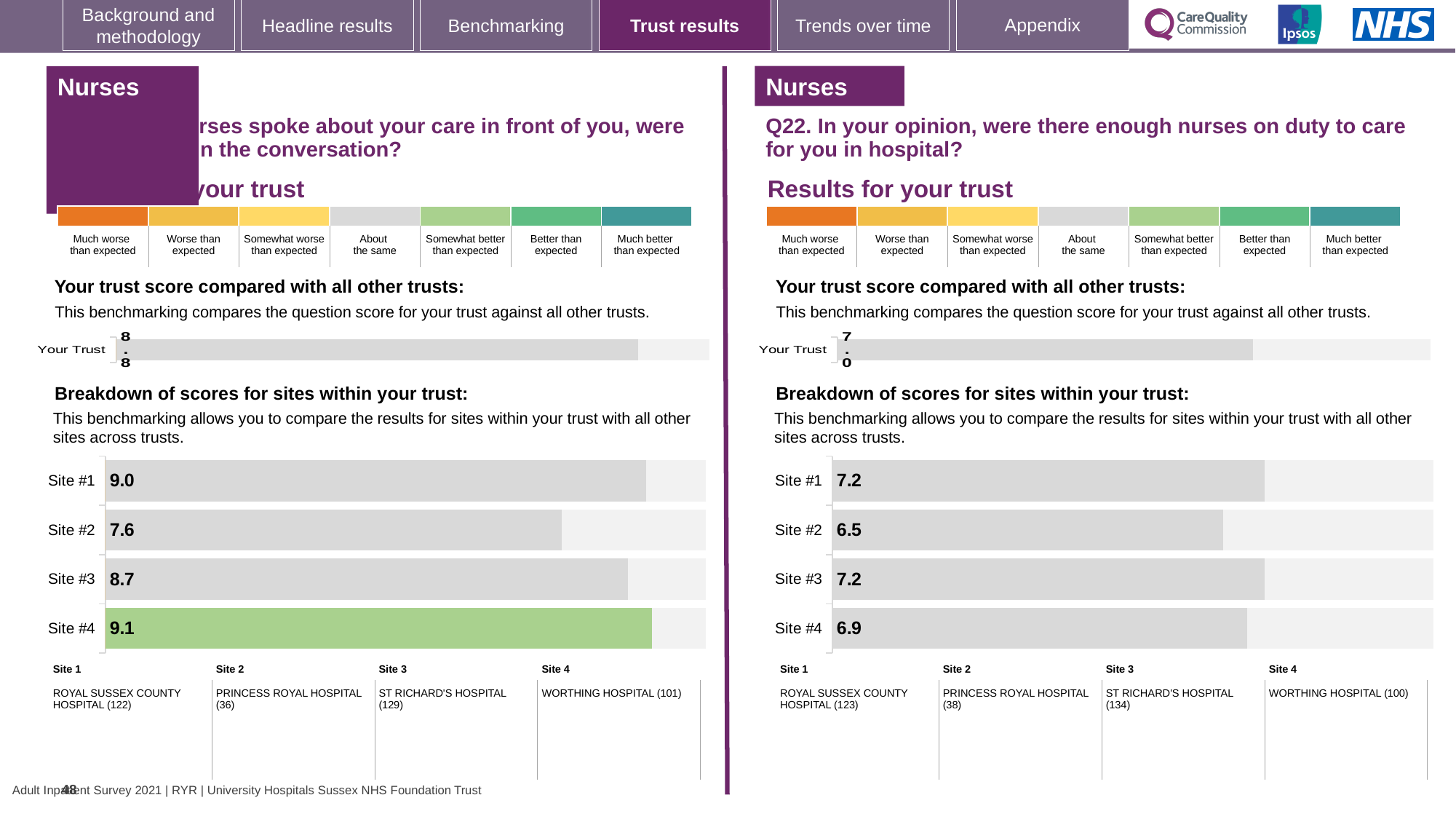
In the left-hand site breakdown chart, which site's bar is coloured green rather than grey? Site #4 In the right-hand site breakdown chart (Q22), what is the difference between the scores for Site #1 and Site #4? 0.3 What is the 'Your Trust' score shown in the right-hand panel (Q22)? 7.0 In the right-hand site breakdown chart (Q22), what is the score for Site #2? 6.5 In the left-hand site breakdown chart, what is the difference between the scores for Site #4 and Site #2? 1.5 How many sites are shown in the left-hand site breakdown chart? 4 In the left-hand site breakdown chart, which site has the lowest score? Site #2 In the left-hand site breakdown chart, which site has the highest score? Site #4 In the right-hand site breakdown chart (Q22), which site has the lowest score? Site #2 In the right-hand site breakdown chart (Q22), which has the larger score, Site #3 or Site #4? Site #3 What type of chart is used for the site breakdown on the right-hand side (Q22)? Bar chart In the left-hand site breakdown chart, what is the score for Site #1? 9.0